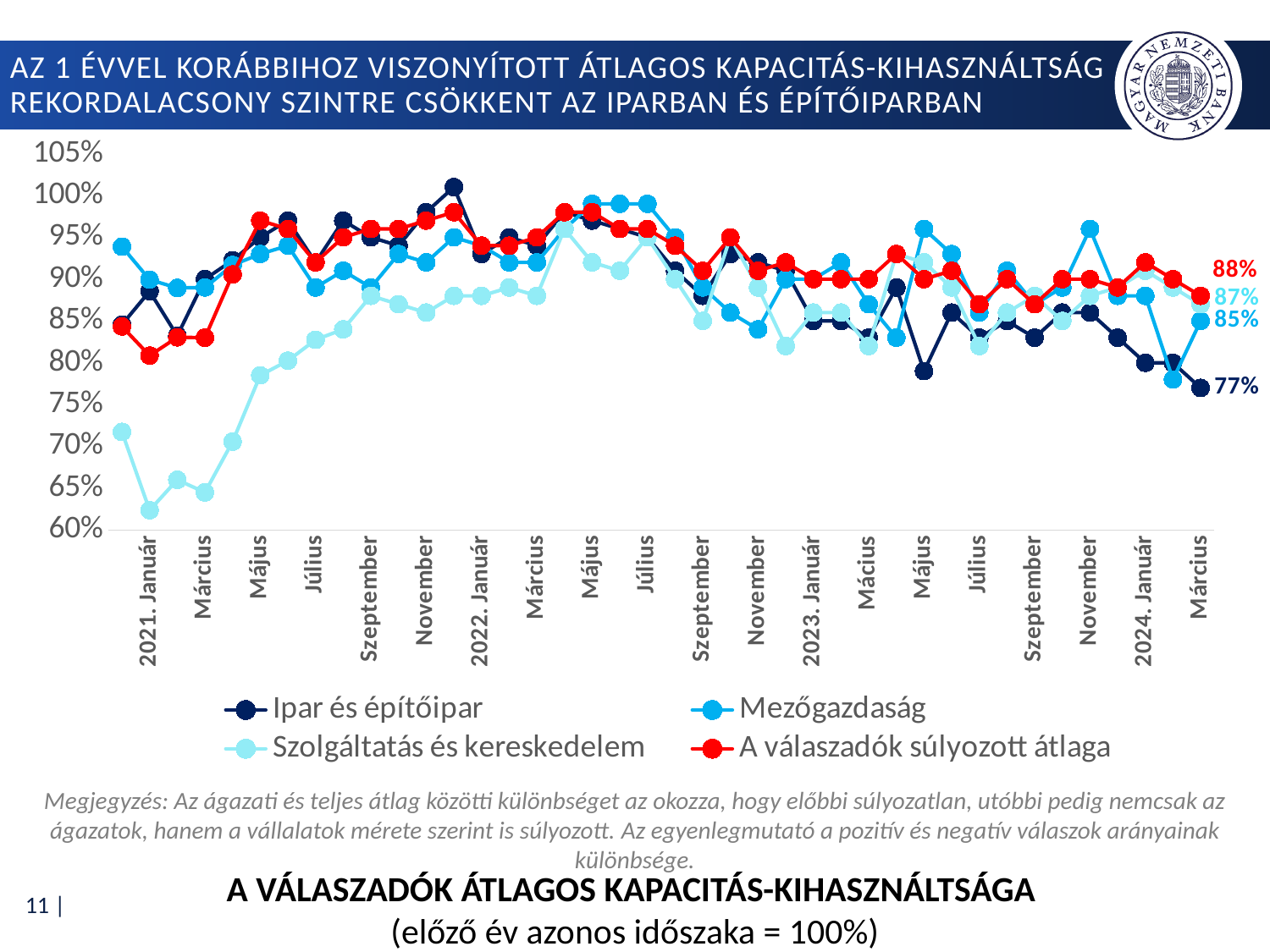
At the last point (2024 Március), which is higher: Ipar és építőipar or Mezőgazdaság? Mezőgazdaság Which series has the lowest value at the last point (2024 Március)? Ipar és építőipar What is the value for Ipar és építőipar at the last point (2024 Március)? 77% How many series does the legend list? 4 What kind of chart is shown on the slide? line chart What is the value for Mezőgazdaság at the last point (2024 Március)? 85% What is the difference between A válaszadók súlyozott átlaga and Ipar és építőipar at the last point (2024 Március)? 11 percentage points What is the value for Szolgáltatás és kereskedelem at the last point (2024 Március)? 87% Is the value for Szolgáltatás és kereskedelem in 2021. Január greater or less than 75%? less What is the title printed below the chart? A VÁLASZADÓK ÁTLAGOS KAPACITÁS-KIHASZNÁLTSÁGA (előző év azonos időszaka = 100%) What is the value for A válaszadók súlyozott átlaga at the last point (2024 Március)? 88% Does the Ipar és építőipar series rise or fall between November 2023 and Március 2024? fall